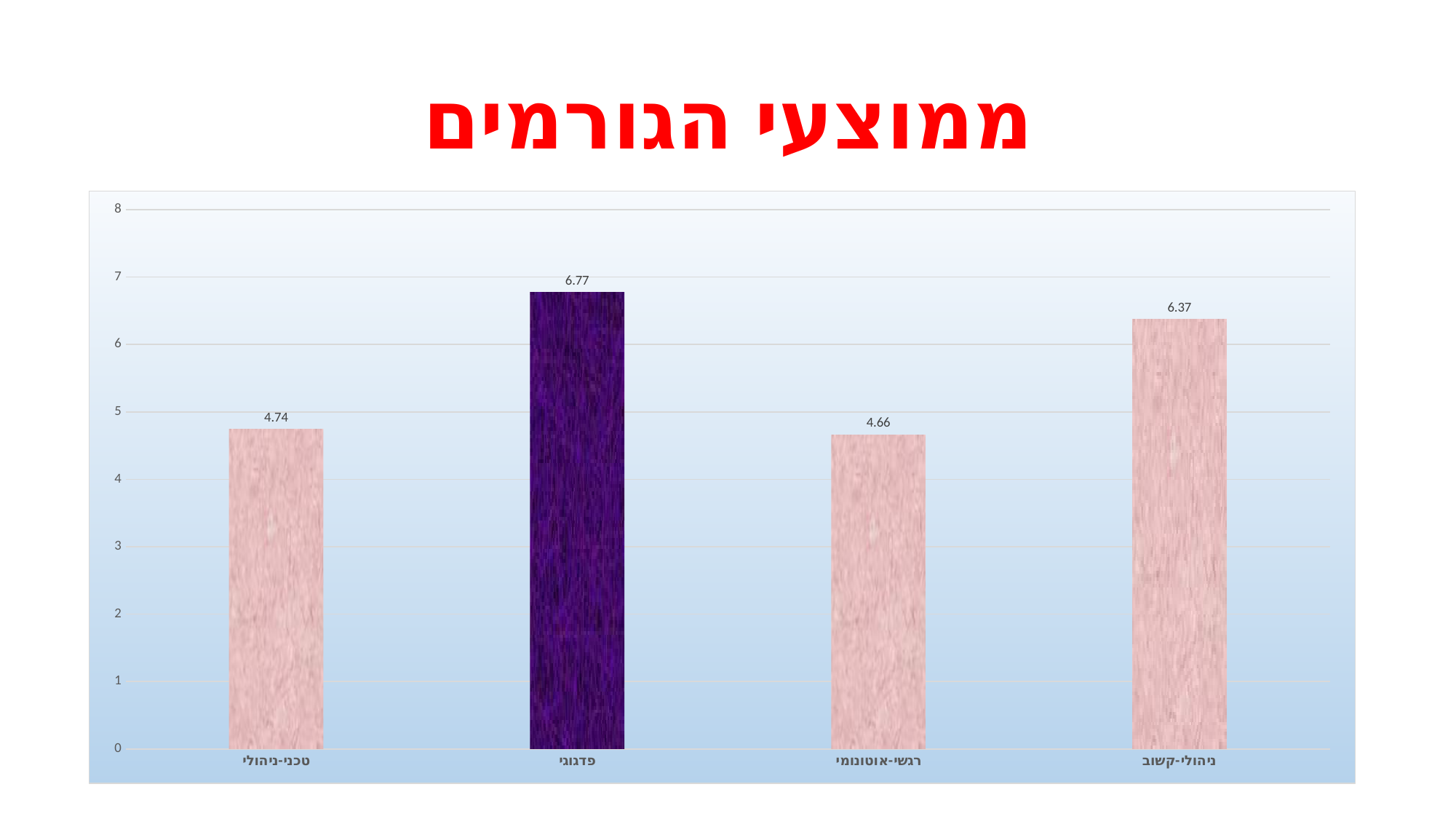
Which category has the highest value? פדגוגי What is the value for רגשי-אוטונומי? 4.66 What is the value for טכני-ניהולי? 4.74 What is the value for פדגוגי? 6.77 What is the value for ניהולי-קשוב? 6.37 Which category has the lowest value? רגשי-אוטונומי Which is larger, the value for ניהולי-קשוב or the value for טכני-ניהולי? ניהולי-קשוב What is the difference between the values for פדגוגי and טכני-ניהולי? 2.03 How many categories are shown in the chart? 4 What is the title of the slide? ממוצעי הגורמים What kind of chart is shown on the slide? Bar chart What is the difference between the values for פדגוגי and ניהולי-קשוב? 0.40